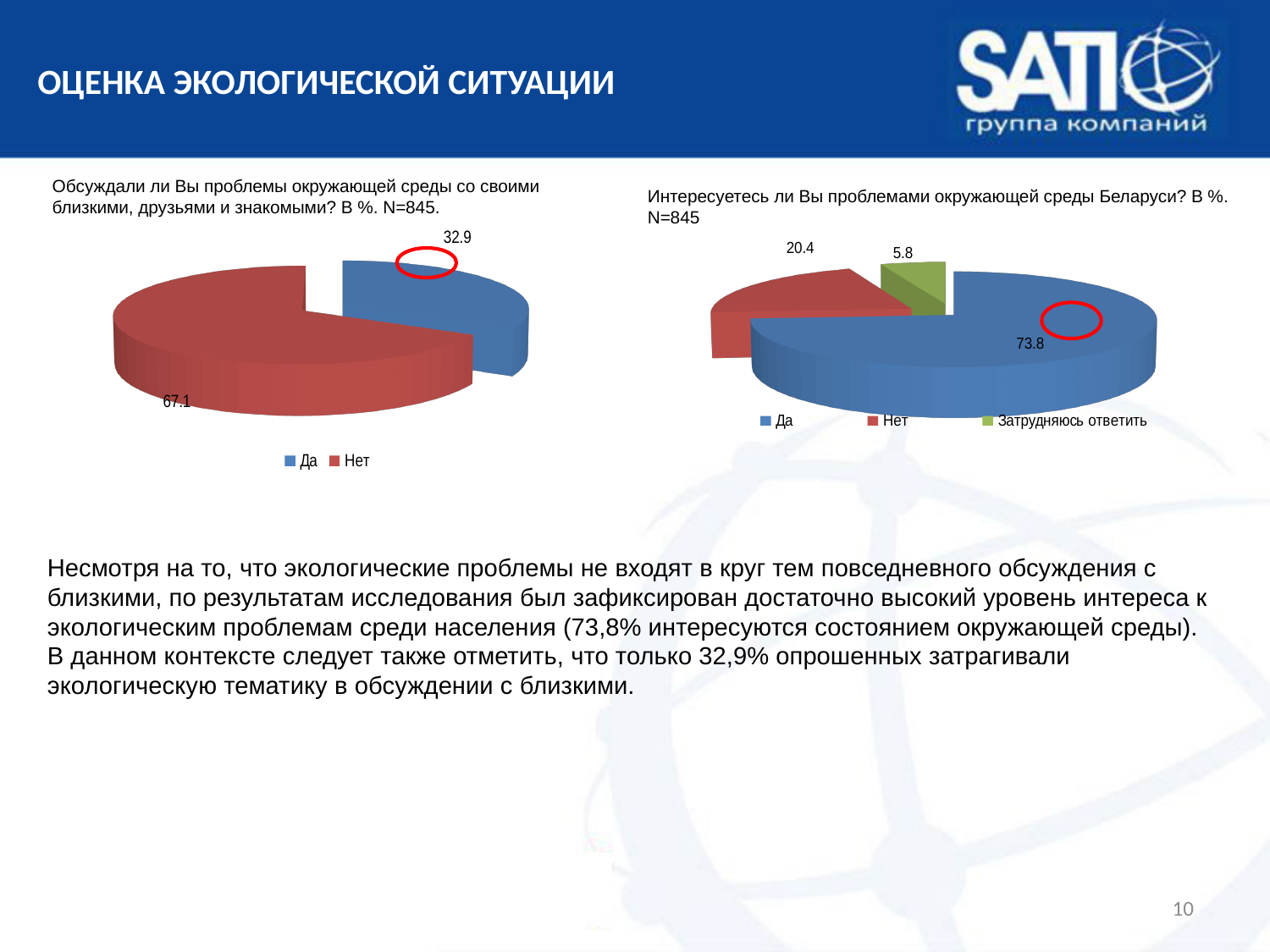
In the right pie chart (Интересуетесь ли Вы проблемами окружающей среды Беларуси?), what is the difference between Да and Нет? 53.4 In the left pie chart (Обсуждали ли Вы проблемы окружающей среды...), what is the value for Нет? 67.1 In the left pie chart (Обсуждали ли Вы проблемы окружающей среды...), what is the difference between Нет and Да? 34.2 In the left pie chart (Обсуждали ли Вы проблемы окружающей среды...), which category has the larger slice? Нет In the right pie chart (Интересуетесь ли Вы проблемами окружающей среды Беларуси?), which category has the smallest slice? Затрудняюсь ответить In the right pie chart (Интересуетесь ли Вы проблемами окружающей среды Беларуси?), what is the value for Да? 73.8 In the right pie chart (Интересуетесь ли Вы проблемами окружающей среды Беларуси?), which category has the largest slice? Да In the left pie chart (Обсуждали ли Вы проблемы окружающей среды...), what is the value for Да? 32.9 How many categories does the legend of the right pie chart (Интересуетесь ли Вы проблемами окружающей среды Беларуси?) list? 3 What type of chart is used on the left side of the slide? Pie chart In the right pie chart (Интересуетесь ли Вы проблемами окружающей среды Беларуси?), what is the value for Затрудняюсь ответить? 5.8 How many slices does the left pie chart (Обсуждали ли Вы проблемы окружающей среды...) have? 2